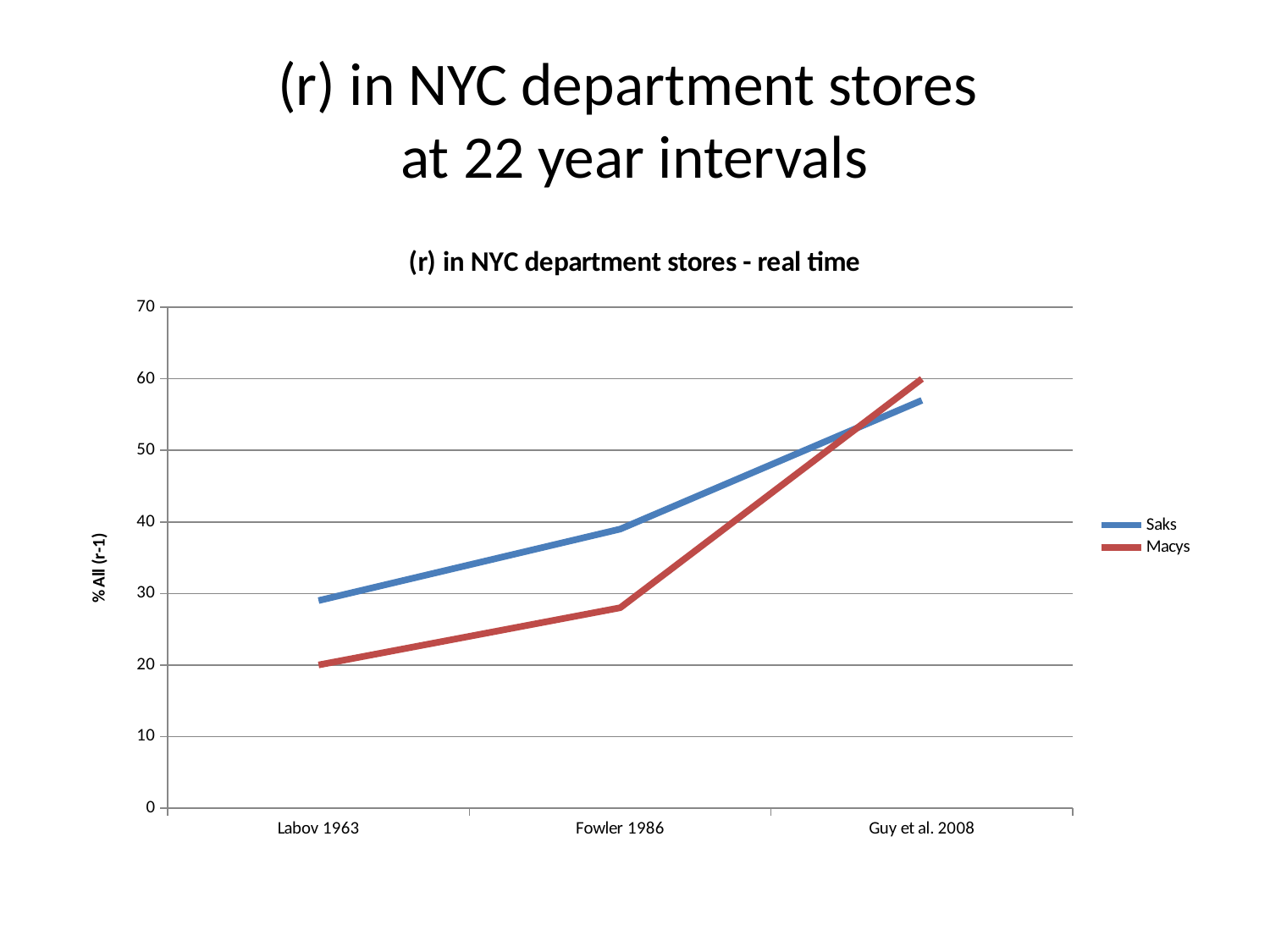
How many series does the legend list? 2 What kind of chart is shown on the slide? line chart Does the Saks line rise or fall from Labov 1963 to Guy et al. 2008? rise Does the Macys line rise or fall from Labov 1963 to Guy et al. 2008? rise How many points along the x axis does each line have? 3 What is the title of the chart? (r) in NYC department stores - real time At Labov 1963, which series has the higher value, Saks or Macys? Saks What is the label on the y axis? % All (r-1) Is the value for Saks at Labov 1963 greater or less than 20? greater At Fowler 1986, which series has the higher value, Saks or Macys? Saks Is the value for Macys at Guy et al. 2008 greater or less than 50? greater Is the value for Macys at Fowler 1986 greater or less than 30? less